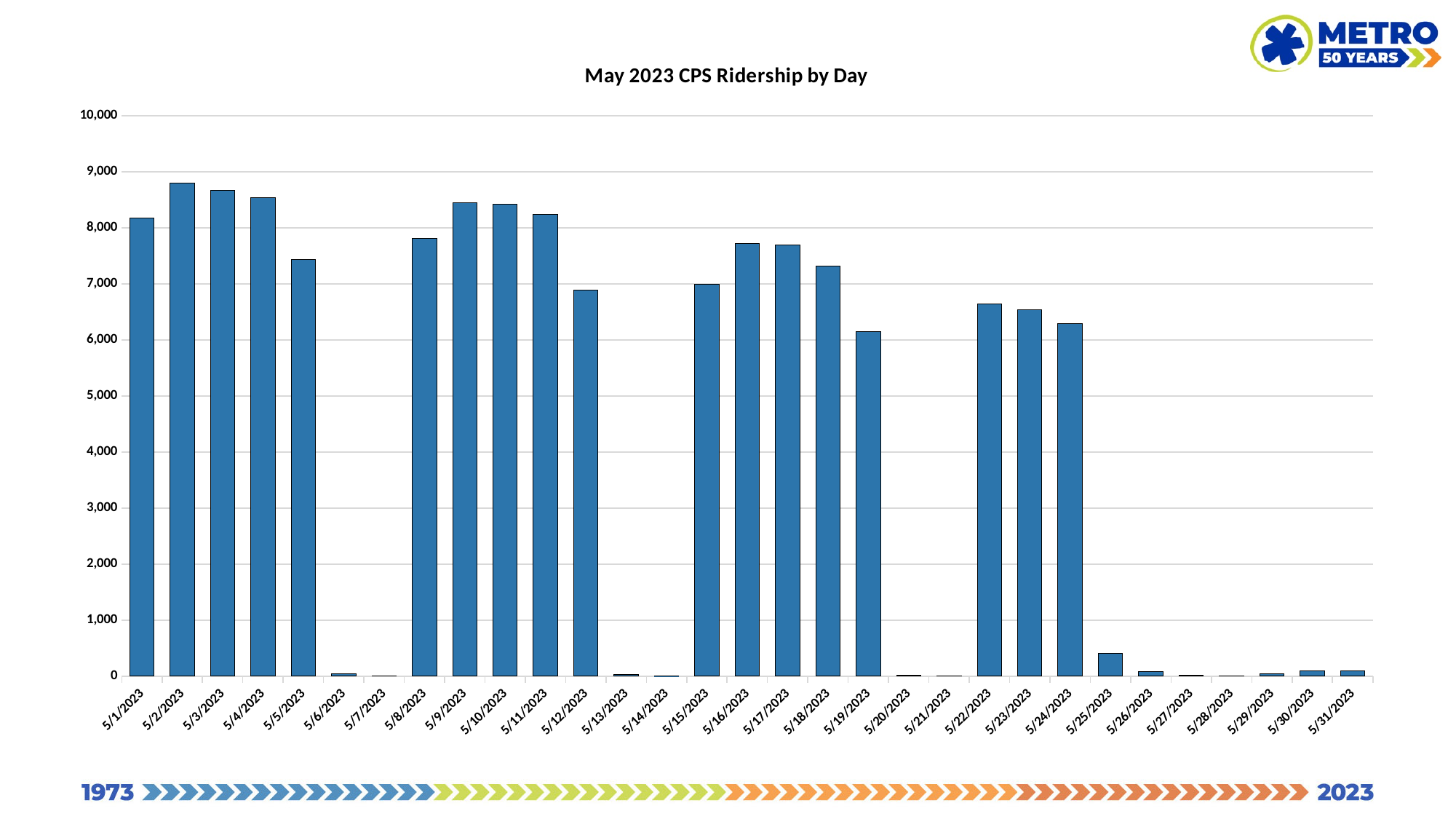
What type of chart is shown on the slide? bar chart Which is larger, the value for 5/9/2023 or the value for 5/16/2023? 5/9/2023 Is the value for 5/25/2023 greater or less than 1,000? less Is the value for 5/18/2023 greater or less than 7,000? greater Is the value for 5/8/2023 greater or less than 8,000? less Which is larger, the value for 5/2/2023 or the value for 5/5/2023? 5/2/2023 Which day has the highest ridership? 5/2/2023 What is the title of the chart? May 2023 CPS Ridership by Day How many days (categories) are plotted on the x axis? 31 From 5/22/2023 to 5/24/2023, do the values rise or fall? fall